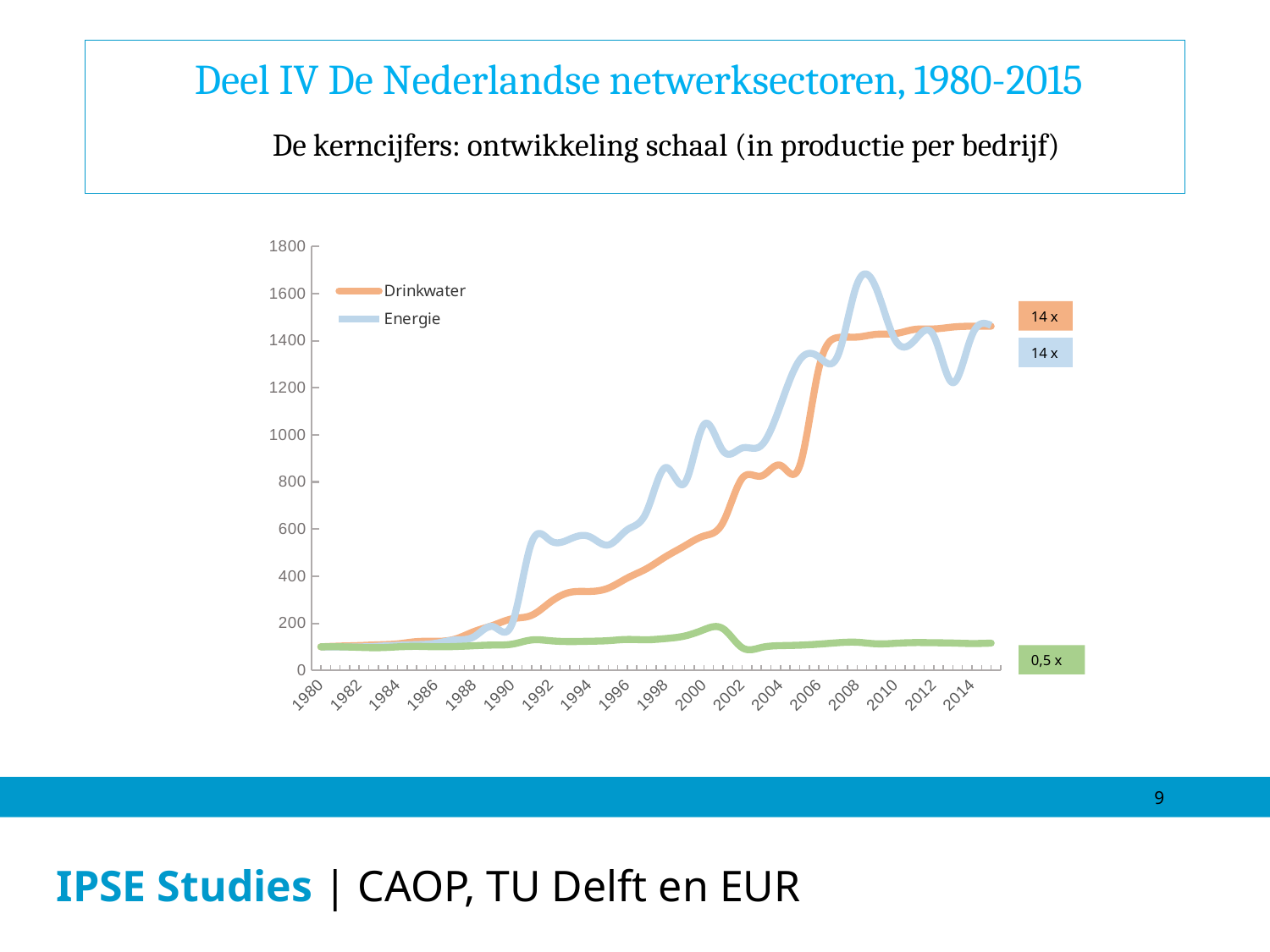
In 2000, which series has the higher value, Drinkwater or Energie? Energie Does the Drinkwater line rise or fall from 1980 to 2014? rise Is the value for Energie in 2008 greater or less than 1400? greater What kind of chart is shown on the slide? line chart How many series does the legend list? 2 Is the value for Energie in 1992 greater or less than 400? greater Is the value for Drinkwater in 2000 greater or less than 800? less What label is printed at the right end of the green line? 0,5 x What label is printed at the right end of the Drinkwater line? 14 x Which series reaches the highest value anywhere on the chart? Energie